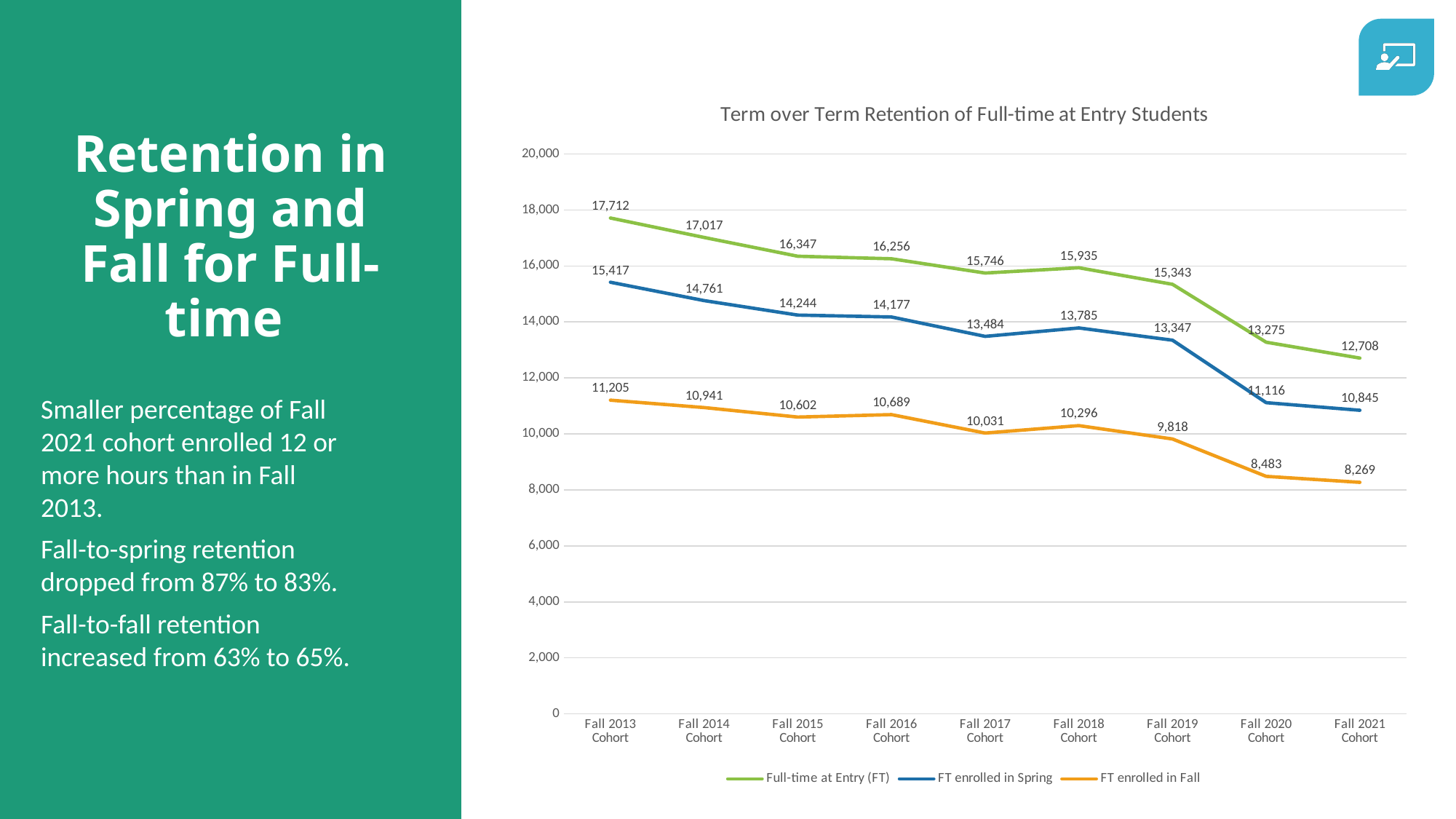
How many series does the legend list? 3 What is the value for Full-time at Entry (FT) for the Fall 2013 Cohort? 17,712 What is the value for FT enrolled in Fall for the Fall 2018 Cohort? 10,296 Which cohort has the lowest value for Full-time at Entry (FT)? Fall 2021 Cohort What is the difference between Full-time at Entry (FT) and FT enrolled in Spring for the Fall 2020 Cohort? 2,159 What is the value for FT enrolled in Spring for the Fall 2021 Cohort? 10,845 Which cohort has the highest value for FT enrolled in Fall? Fall 2013 Cohort How many cohorts are shown on the x axis? 9 Is the value for FT enrolled in Fall for the Fall 2021 Cohort greater or less than 10,000? less What is the title of the chart? Term over Term Retention of Full-time at Entry Students What kind of chart is shown on the slide? line chart Which is larger: FT enrolled in Spring for the Fall 2017 Cohort or for the Fall 2018 Cohort? Fall 2018 Cohort